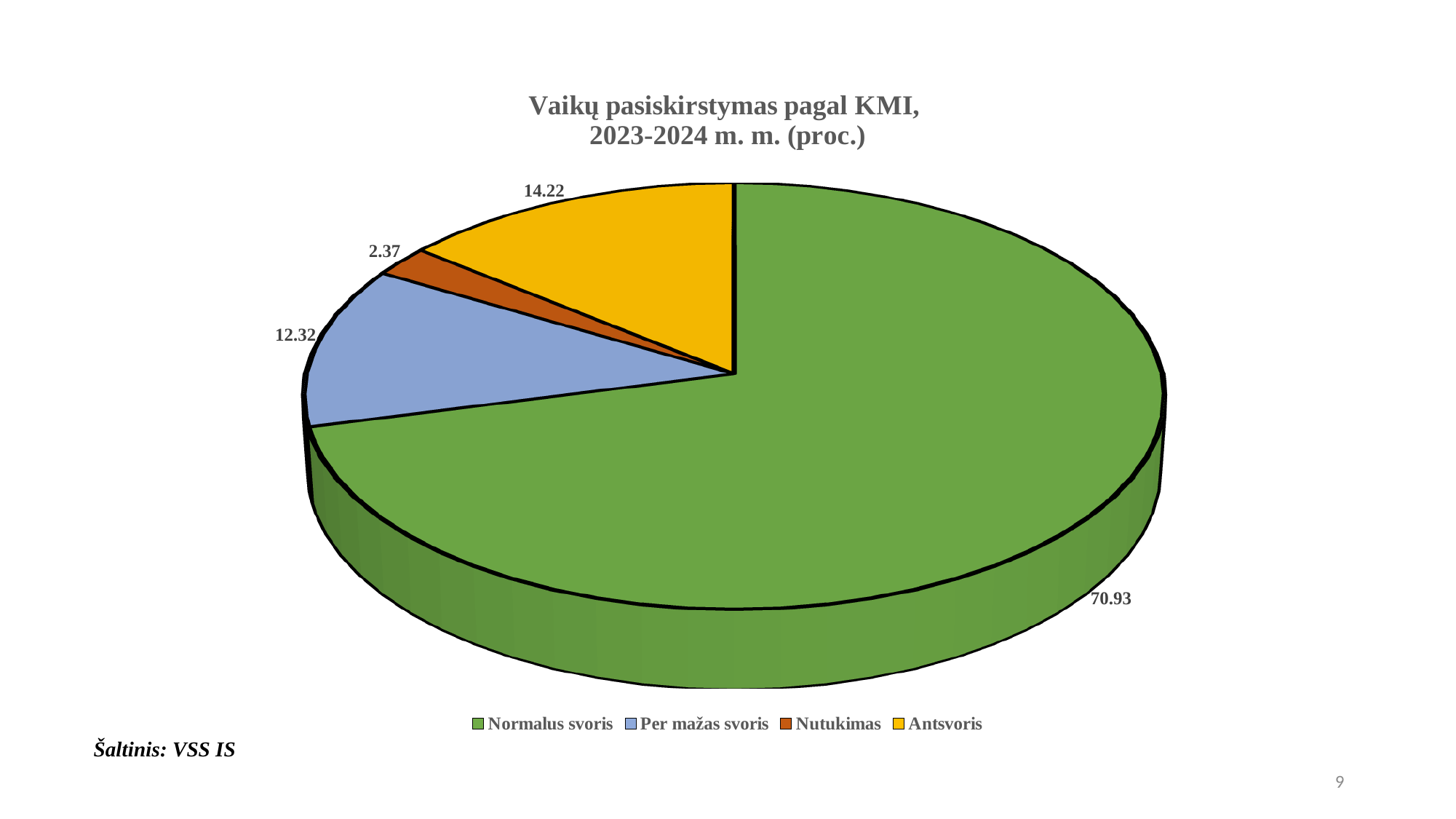
What type of chart is shown on the slide? Pie chart Which category has the smallest slice of the pie? Nutukimas Which colour represents Antsvoris in the legend? Yellow Which is larger, the value for Antsvoris or the value for Per mažas svoris? Antsvoris How many categories does the pie chart show? 4 What is the value for Per mažas svoris? 12.32 What is the title of the chart? Vaikų pasiskirstymas pagal KMI, 2023-2024 m. m. (proc.) What is the value for Nutukimas? 2.37 Which category has the largest slice of the pie? Normalus svoris What is the difference between the values for Antsvoris and Per mažas svoris? 1.90 What is the value for Normalus svoris? 70.93 What is the value for Antsvoris? 14.22